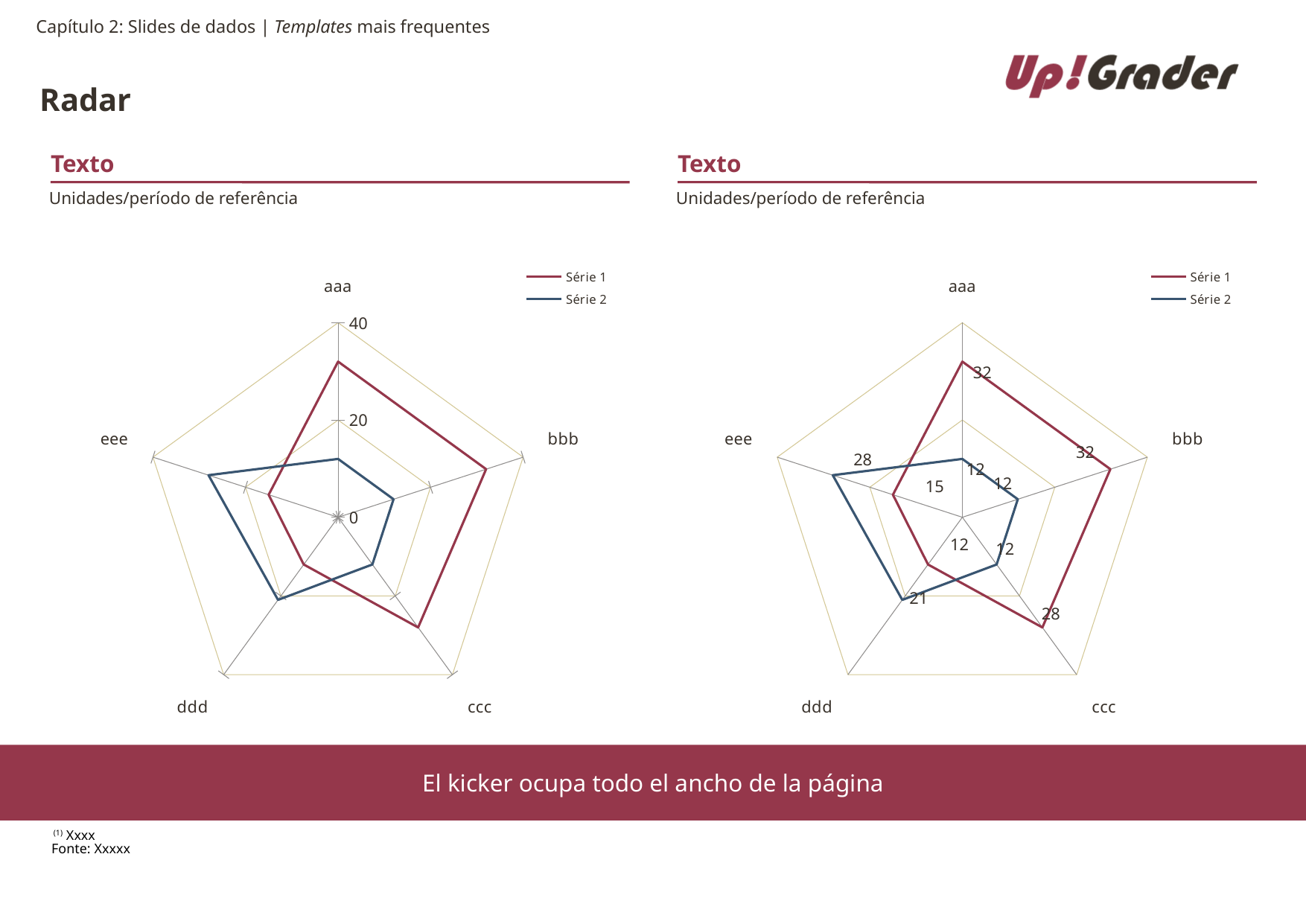
How many categories (axes) does the left-hand radar chart have? 5 In the right-hand radar chart, which category has the lowest Série 1 value? ddd In the right-hand radar chart, what is the Série 2 value for eee? 28 In the left-hand radar chart, is the Série 1 value for aaa greater or less than 20? greater In the right-hand radar chart, what is the Série 1 value for aaa? 32 In the right-hand radar chart, what is the Série 1 value for ddd? 12 What type of chart is shown on the left side of the slide? Radar chart In the left-hand radar chart, is the Série 2 value for aaa greater or less than 20? less In the right-hand radar chart, which category has the highest Série 2 value? eee In the right-hand radar chart, which series has the larger value for ddd? Série 2 In the right-hand radar chart, what is the difference between the Série 1 and Série 2 values for ccc? 16 How many series does the legend of the right-hand chart list? 2